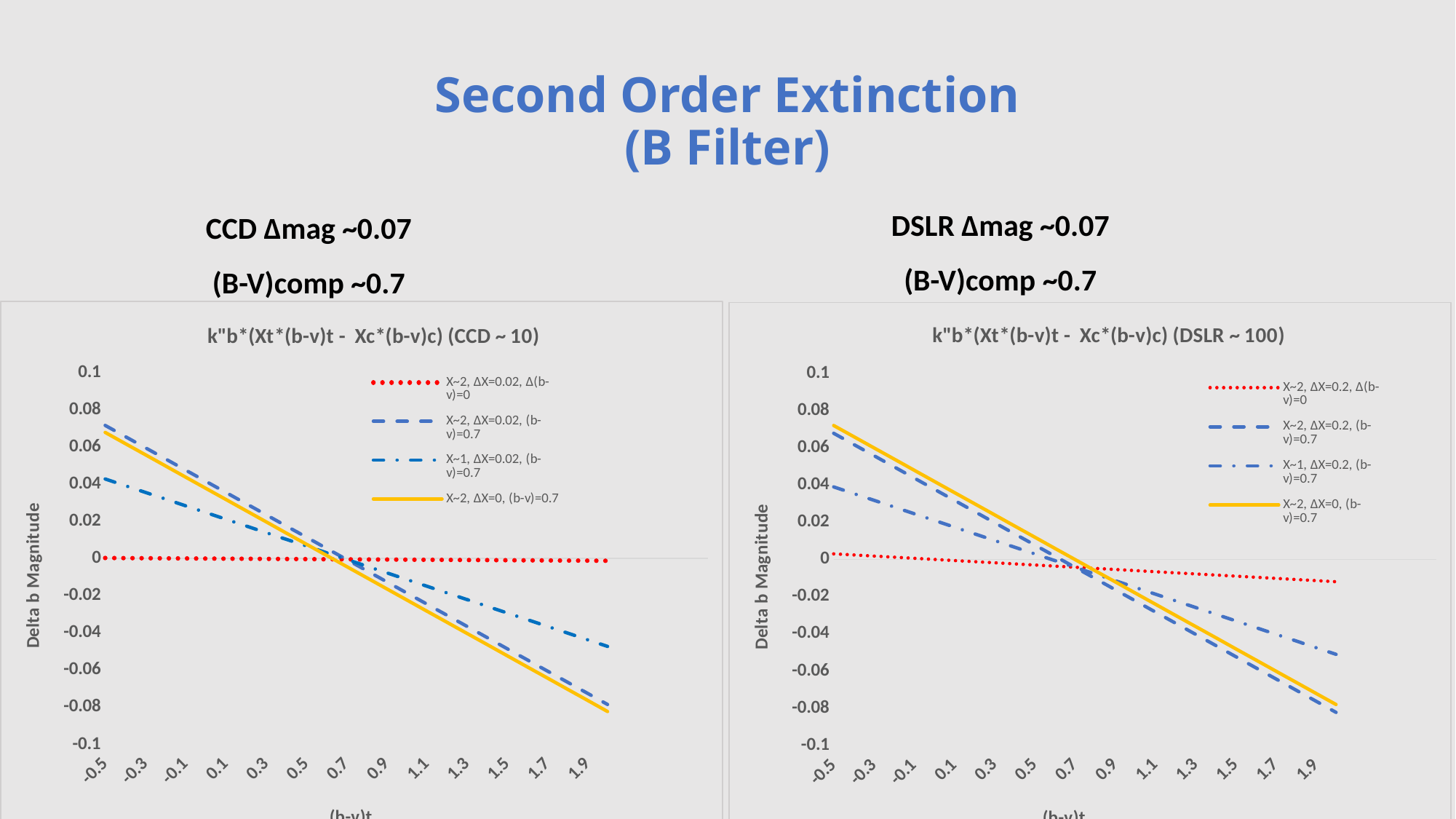
In the left chart (CCD ~ 10), what colour is the dotted line for "X~2, ΔX=0.02, Δ(b-v)=0"? Red What kind of chart is the left chart titled "k"b*(Xt*(b-v)t - Xc*(b-v)c) (CCD ~ 10)"? Line chart In the left chart (CCD ~ 10), is the value of the solid yellow line at (b-v)t = -0.5 greater or less than 0.04? greater What is the y-axis title of the right chart (DSLR ~ 100)? Delta b Magnitude How many series does the legend of the left chart (CCD ~ 10) list? 4 How many series does the legend of the right chart (DSLR ~ 100) list? 4 In the right chart (DSLR ~ 100), does the dash-dot line "X~1, ΔX=0.2, (b-v)=0.7" rise or fall as (b-v)t increases? Fall In the left chart (CCD ~ 10), is the value of the dash-dot line "X~1, ΔX=0.02, (b-v)=0.7" at (b-v)t = 1.9 greater or less than -0.02? less In the right chart (DSLR ~ 100), is the value of the solid yellow line at (b-v)t = -0.5 greater or less than 0.06? greater In the left chart (CCD ~ 10), does the solid yellow line "X~2, ΔX=0, (b-v)=0.7" rise or fall as (b-v)t increases? Fall In the left chart (CCD ~ 10), at (b-v)t = -0.5, which line is higher: the dashed line "X~2, ΔX=0.02, (b-v)=0.7" or the dash-dot line "X~1, ΔX=0.02, (b-v)=0.7"? The dashed line (X~2, ΔX=0.02, (b-v)=0.7)